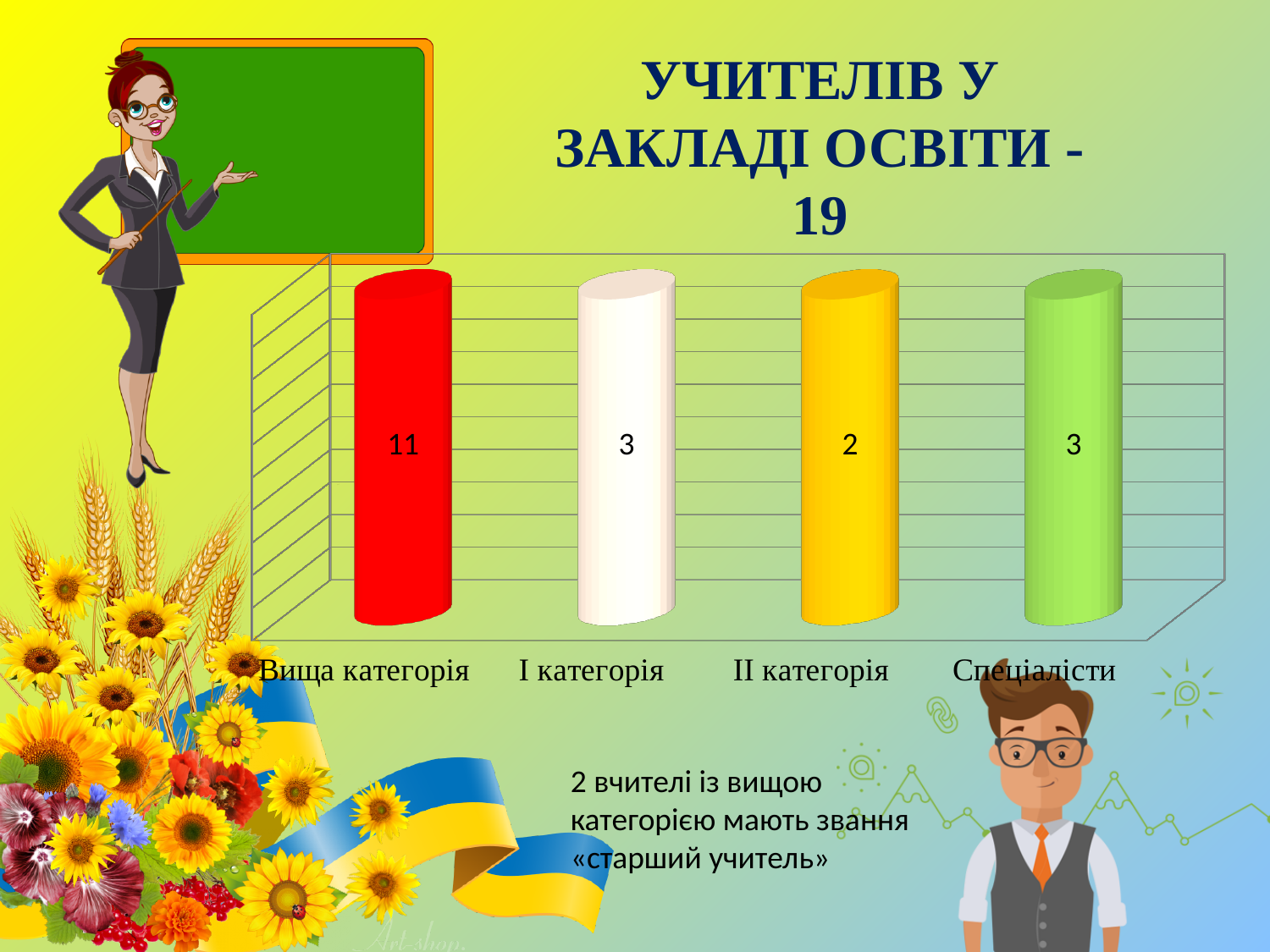
What is the difference between the values for Вища категорія and І категорія? 8 What kind of chart is shown on the slide? bar chart Which category has the highest value? Вища категорія Which category has the lowest value? ІІ категорія What value is shown for І категорія? 3 How many categories are shown in the chart? 4 What is the total of all four values shown in the chart? 19 What value is shown for Спеціалісти? 3 What is the difference between the values for Спеціалісти and ІІ категорія? 1 Which is larger, the value for Вища категорія or the value for Спеціалісти? Вища категорія What value is shown for Вища категорія? 11 What value is shown for ІІ категорія? 2